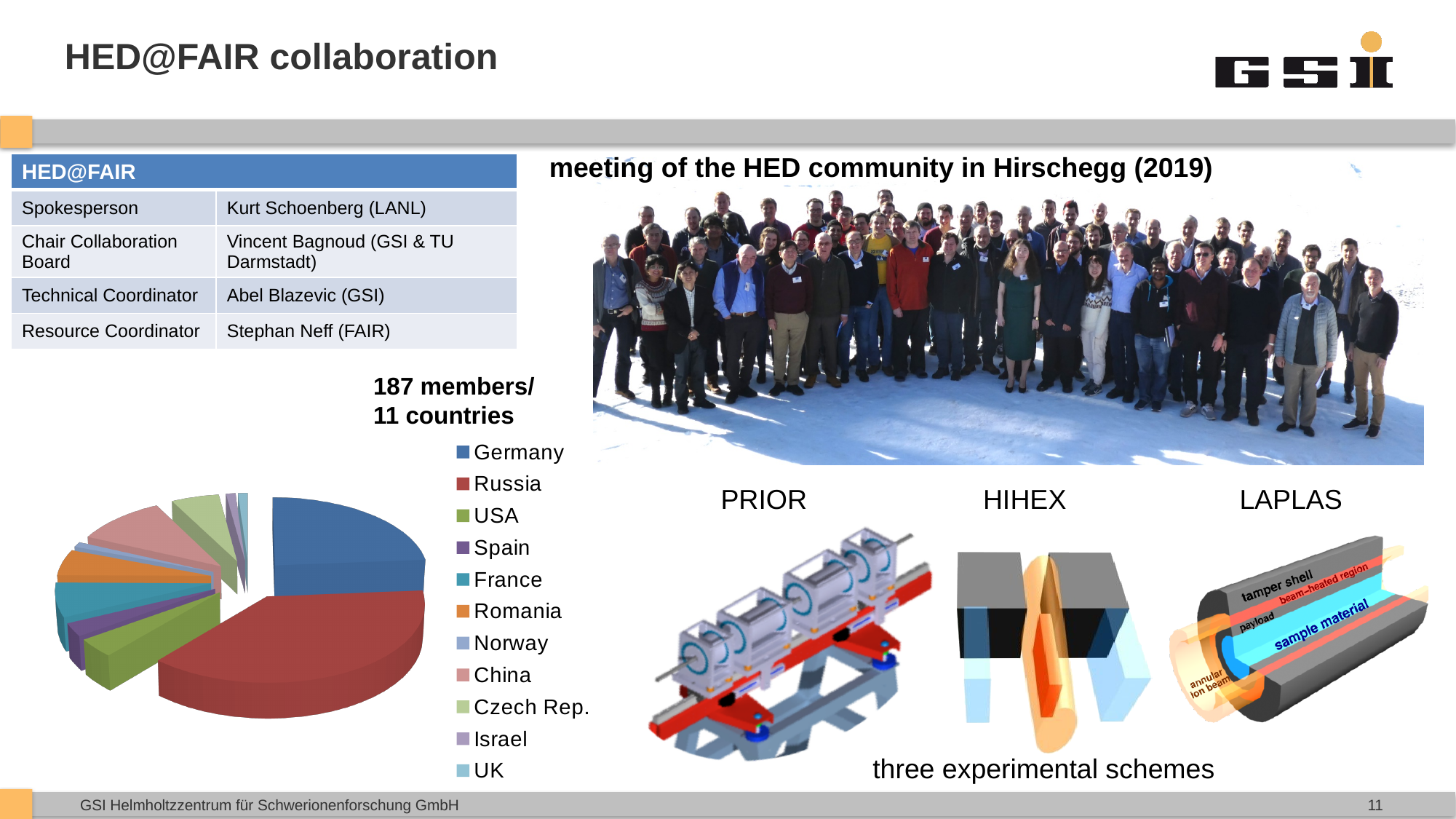
How many entries does the pie chart's legend list? 11 Which country is shown in blue in the pie chart? Germany Which slice is larger in the pie chart, Germany or USA? Germany Which slice is larger in the pie chart, China or Norway? China Which slice is larger in the pie chart, USA or Spain? USA How many countries (slices) does the pie chart show? 11 According to the text above the pie chart, how many members does the collaboration have? 187 members Which country has the largest slice in the pie chart? Russia What kind of chart is shown on the left of the slide? pie chart Which country is listed first in the pie chart legend? Germany